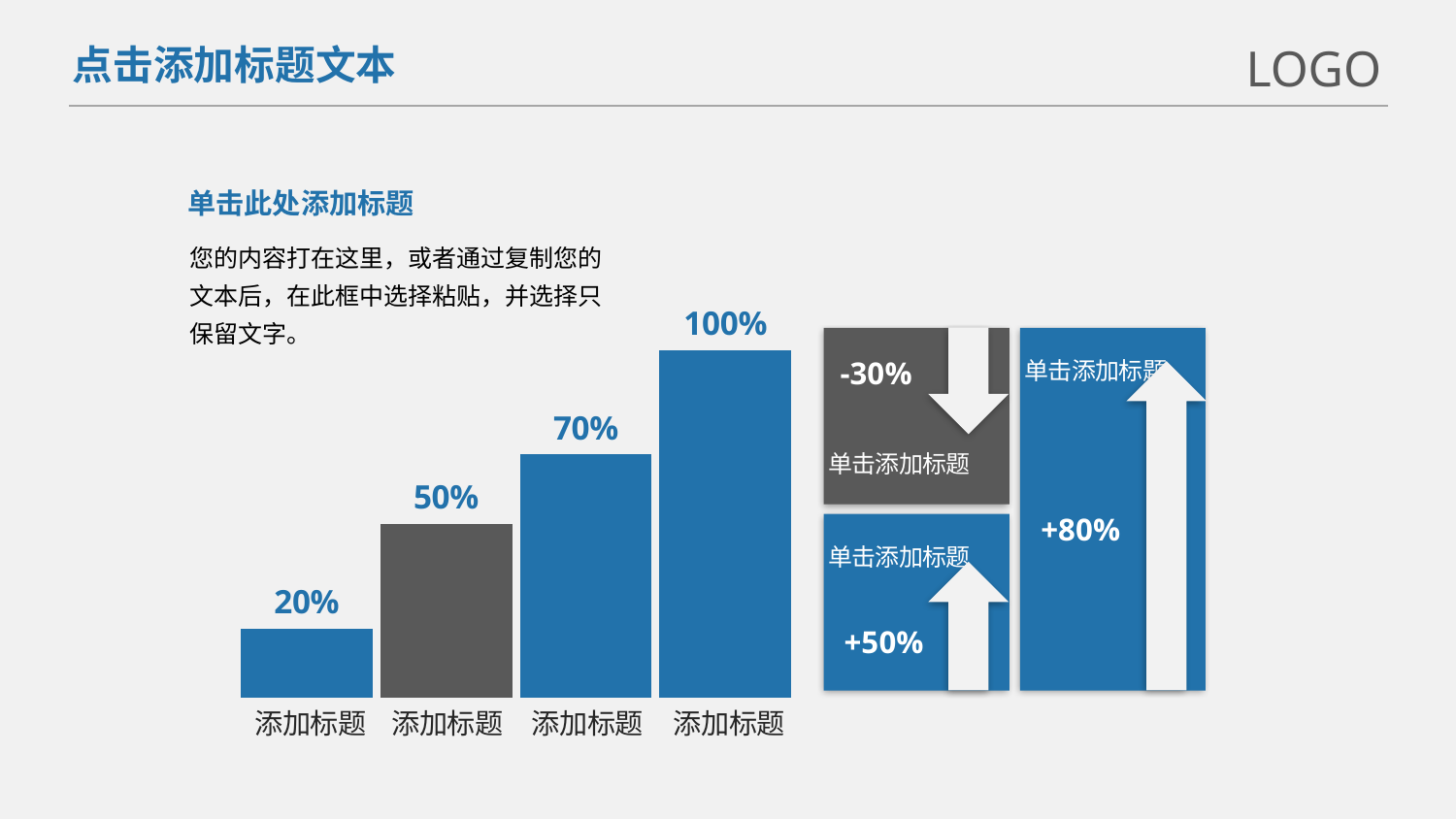
What is the difference between the rightmost bar and the leftmost bar in the bar chart? 80% What is the value of the second bar from the left in the bar chart? 50% How many bars does the bar chart have? 4 Which bar in the bar chart is coloured dark grey rather than blue? the second bar (50%) Which bar in the bar chart has the highest value? the fourth (rightmost) bar, 100% What is the value of the fourth (rightmost) bar in the bar chart? 100% What is the value of the first (leftmost) bar in the bar chart? 20% What type of chart is shown on the slide? bar chart What is the value of the third bar from the left in the bar chart? 70% Which bar in the bar chart has the lowest value? the first (leftmost) bar, 20% Do the bar values rise or fall from left to right in the bar chart? rise What is the difference between the third bar and the second bar in the bar chart? 20%